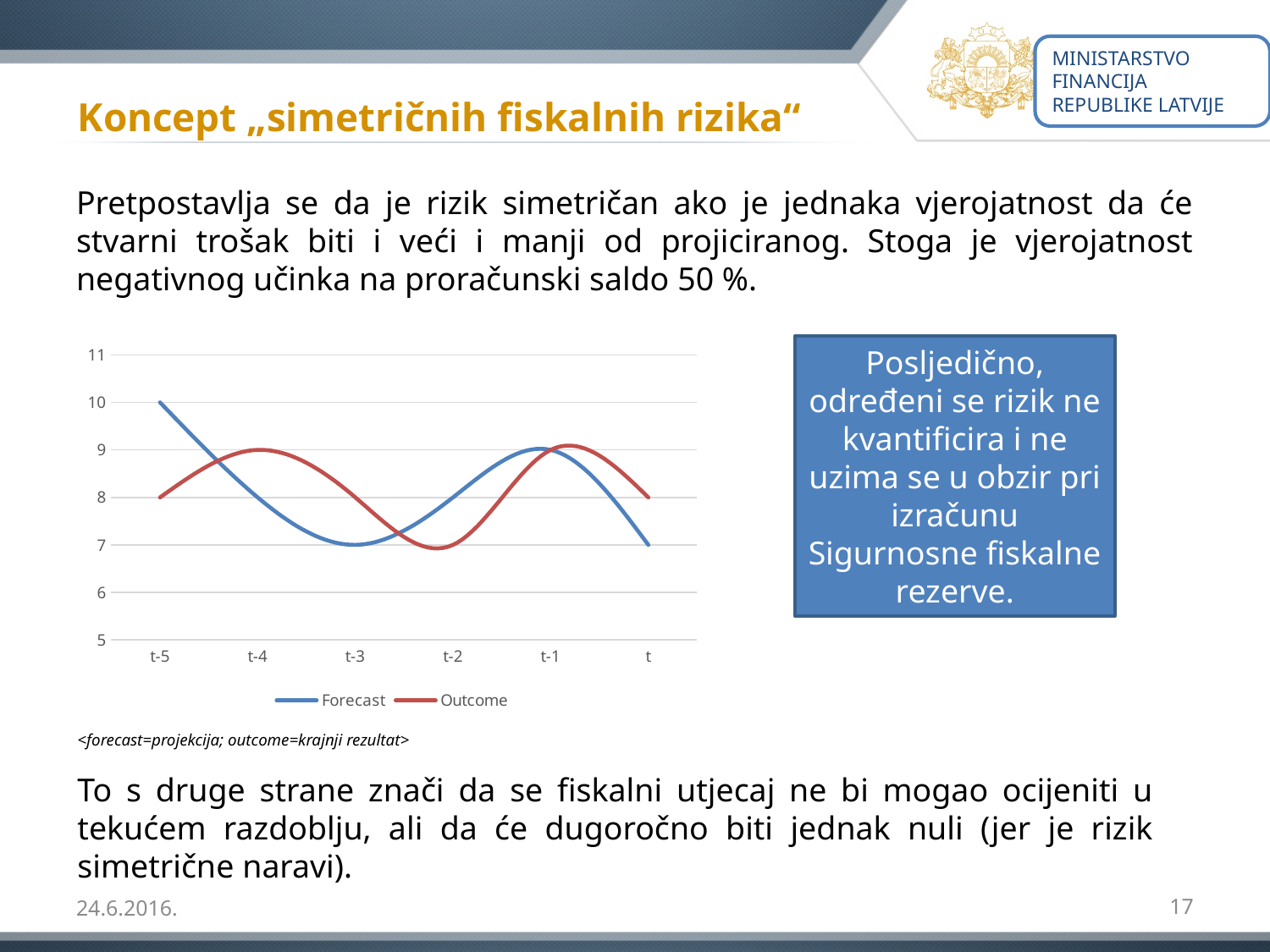
Is the Forecast value at t-3 greater or less than 8? less At which x-axis point is the Outcome series lowest? t-2 What is the Outcome value at t-5? 8 Does the Forecast series rise or fall from t-5 to t-3? fall At which x-axis point is the Forecast series highest? t-5 How many points are on the x axis of the chart? 6 At t-5, which series has the larger value, Forecast or Outcome? Forecast At t-4, which series has the larger value, Forecast or Outcome? Outcome What kind of chart is shown on the slide? line chart What is the Forecast value at t-5? 10 How many series does the chart legend list? 2 What are the two series named in the chart legend? Forecast and Outcome